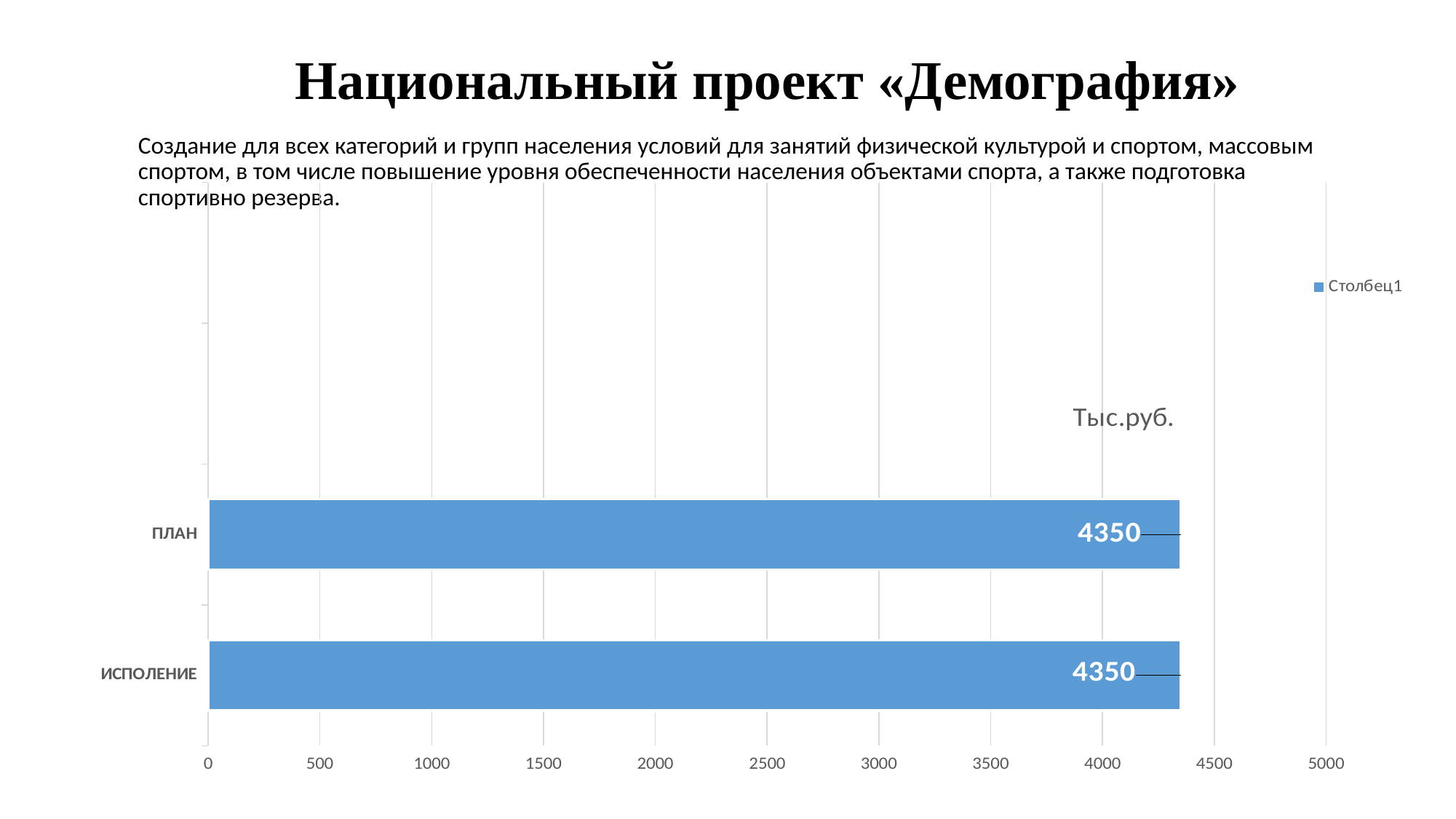
Is the value for ИСПОЛЕНИЕ greater or less than 4500? less Is the value for ПЛАН greater or less than 4000? greater What is the difference between the values for ПЛАН and ИСПОЛЕНИЕ? 0 What unit label is shown on the chart? Тыс.руб. How many categories are shown in the chart? 2 What is the maximum value shown on the horizontal axis? 5000 What is the name of the series listed in the legend? Столбец1 How many series does the legend list? 1 What is the value for ПЛАН? 4350 What kind of chart is shown on the slide? bar chart What is the value for ИСПОЛЕНИЕ? 4350